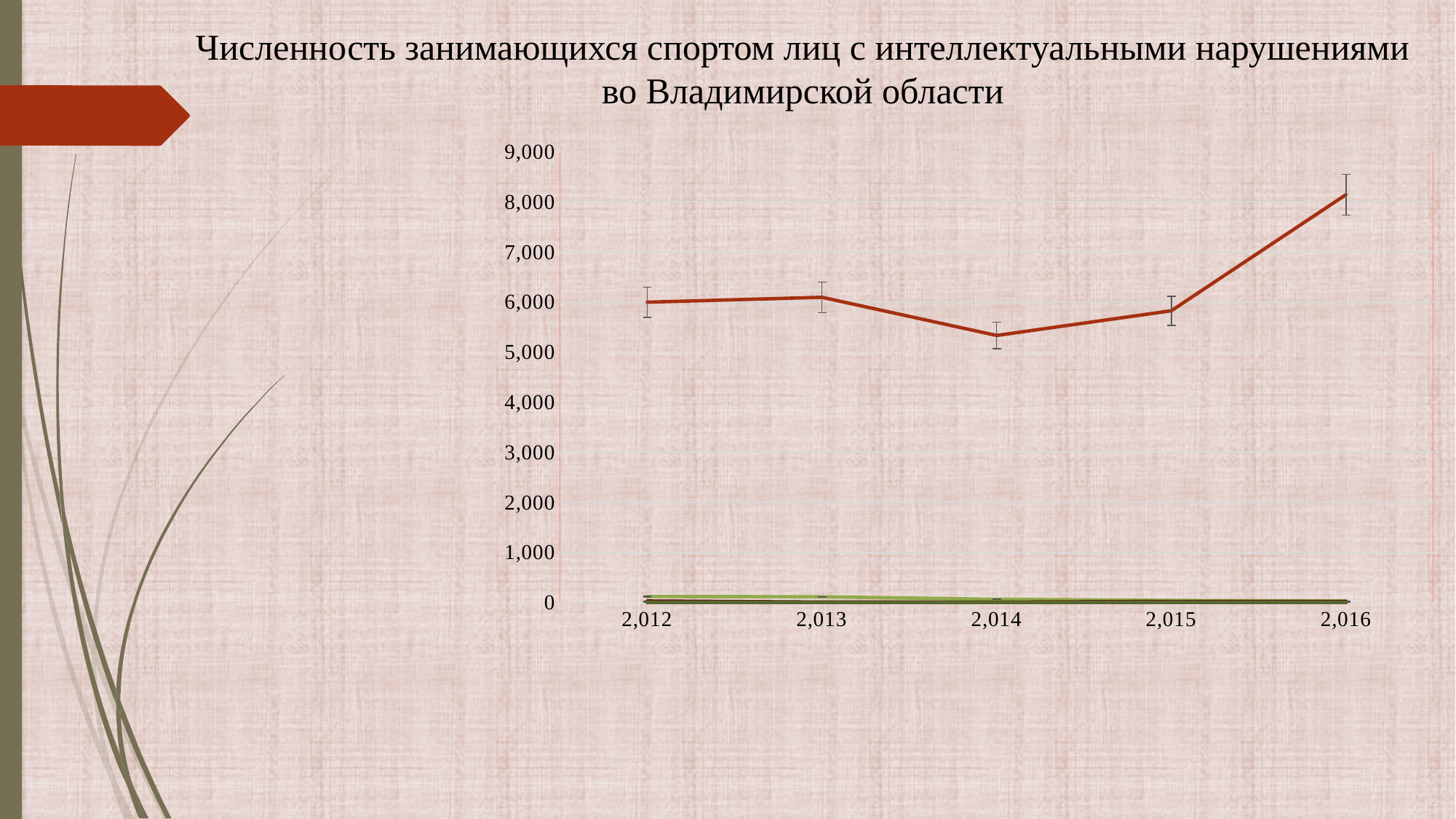
In which year does the red line reach its highest value? 2,016 Which year has the larger value on the red line, 2,012 or 2,016? 2,016 What is the title of the chart on the slide? Численность занимающихся спортом лиц с интеллектуальными нарушениями во Владимирской области Is the value of the red line for 2,015 greater or less than 7,000? less Does the red line rise or fall between 2,015 and 2,016? rise What kind of chart is shown on the slide? line chart In which year does the red line reach its lowest value? 2,014 How many years are shown along the x axis of the chart? 5 Is the value of the red line for 2,014 greater or less than 5,000? greater Is the value of the red line for 2,012 greater or less than 7,000? less Which year has the larger value on the red line, 2,013 or 2,014? 2,013